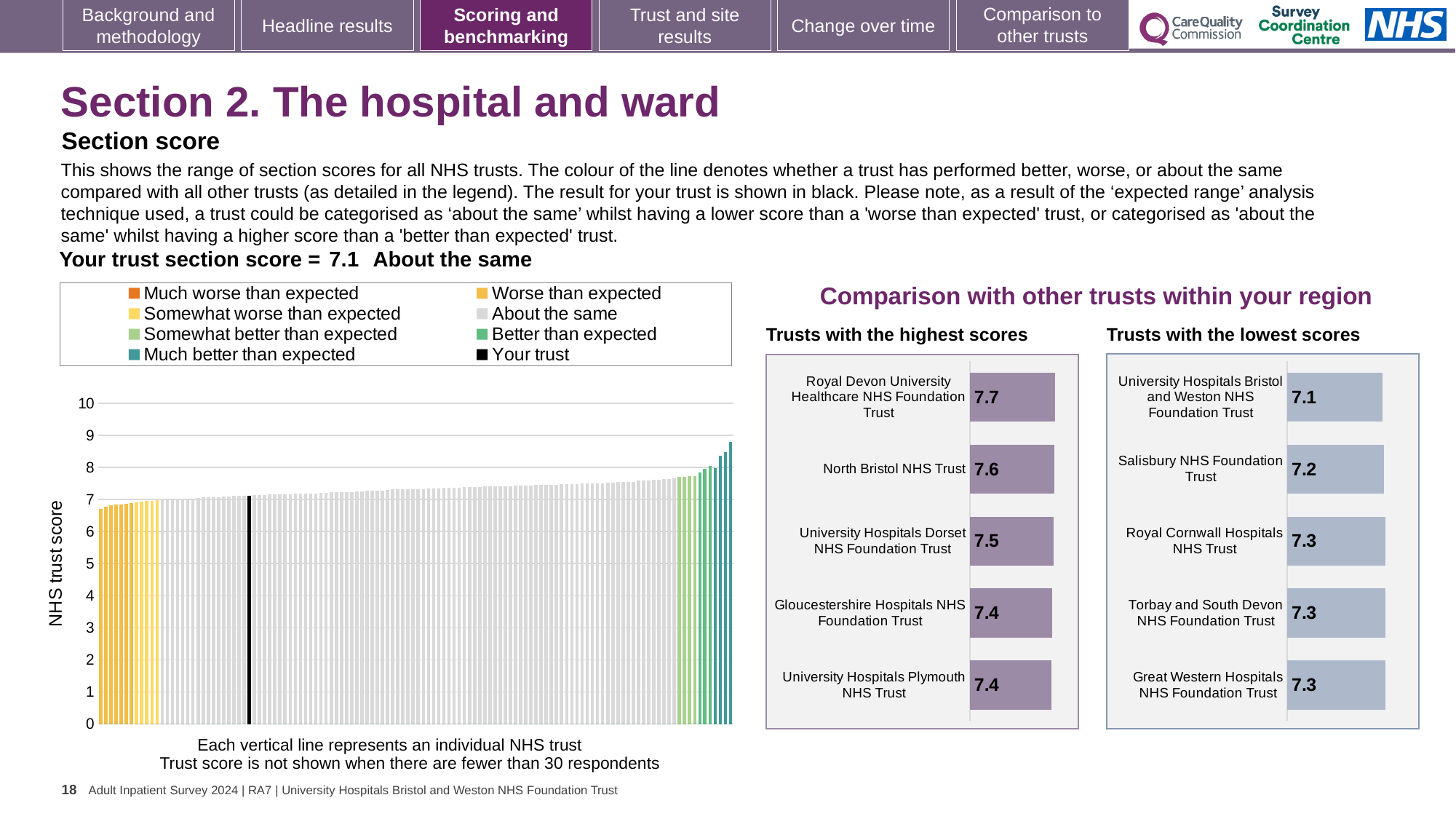
In the 'Trusts with the highest scores' chart, which has the larger score: Royal Devon University Healthcare NHS Foundation Trust or Gloucestershire Hospitals NHS Foundation Trust? Royal Devon University Healthcare NHS Foundation Trust In the 'Trusts with the highest scores' chart, what is the score for Royal Devon University Healthcare NHS Foundation Trust? 7.7 In the 'Trusts with the highest scores' chart, what is the difference between the scores of Royal Devon University Healthcare NHS Foundation Trust and North Bristol NHS Trust? 0.1 How many entries does the legend of the main NHS trust score chart list? 8 In the 'Trusts with the lowest scores' chart, which trust has the lowest score? University Hospitals Bristol and Weston NHS Foundation Trust In the 'Trusts with the highest scores' chart, which trust has the highest score? Royal Devon University Healthcare NHS Foundation Trust In the main NHS trust score chart on the left, what is the section score for your trust (the black line)? 7.1 In the 'Trusts with the lowest scores' chart, what is the score for Salisbury NHS Foundation Trust? 7.2 In the 'Trusts with the lowest scores' chart, what is the difference between the scores of Great Western Hospitals NHS Foundation Trust and University Hospitals Bristol and Weston NHS Foundation Trust? 0.2 In the main NHS trust score chart on the left, is the value of the rightmost (highest) bar greater or less than 8? greater How many trusts are shown in the 'Trusts with the lowest scores' chart? 5 In the main NHS trust score chart on the left, do the trust scores rise or fall from left to right? rise